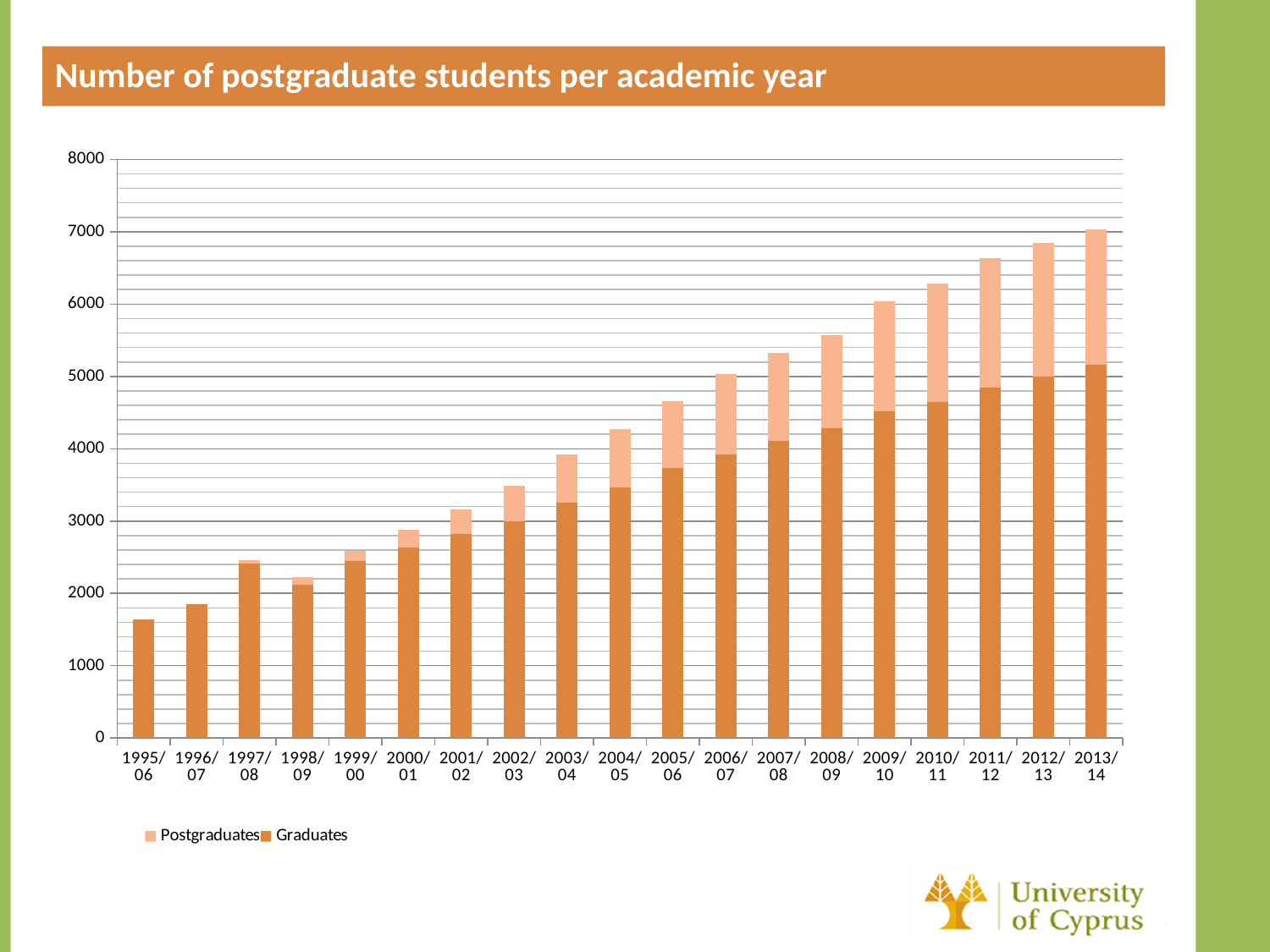
How many series does the legend list? 2 Which academic year has the highest total bar? 2013/14 Is the Graduates value for 2013/14 greater or less than 5000? greater Is the Graduates value for 2004/05 greater or less than 4000? less Do the total bars generally rise or fall from 1995/06 to 2013/14? rise What is the title of the chart? Number of postgraduate students per academic year What kind of chart is shown on the slide? stacked bar chart Which has the larger total bar, 1997/08 or 1998/09? 1997/08 Is the total bar for 1995/06 greater or less than 2000? less What are the two series named in the legend? Postgraduates and Graduates How many academic years are shown on the x axis of the chart? 19 Which academic year has the lowest total bar? 1995/06